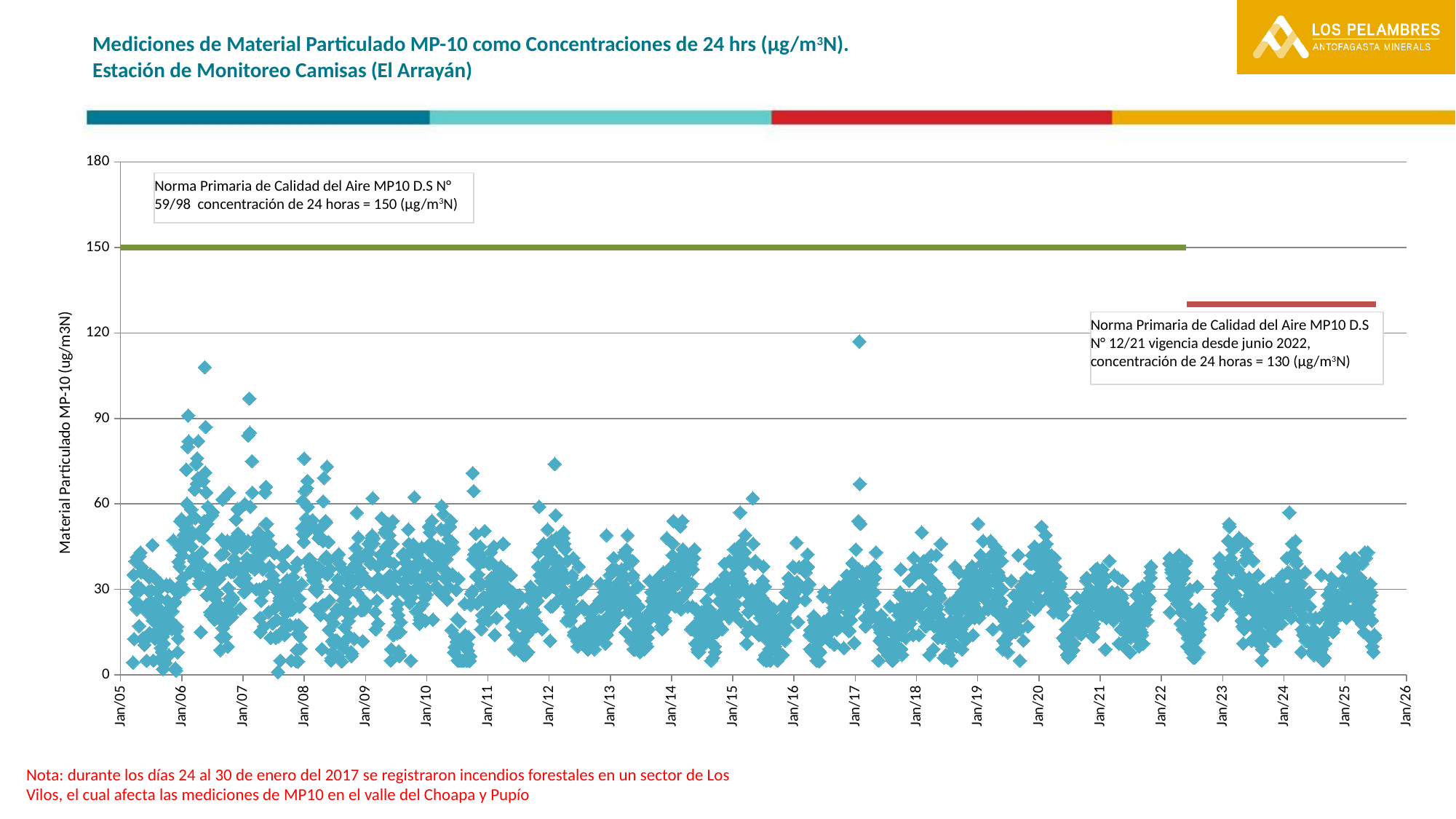
Is the highest plotted MP-10 measurement greater or less than 90? greater What is the label of the vertical axis? Material Particulado MP-10 (ug/m3N) Is the highest plotted MP-10 measurement greater or less than 150? less Is the highest plotted MP-10 measurement greater or less than 120? less What is the maximum value shown on the vertical axis? 180 Since when has the D.S N° 12/21 standard been in force, according to the chart annotation? junio 2022 What is the 24-hour concentration limit set by the Norma Primaria de Calidad del Aire MP10 D.S N° 12/21, as stated on the chart? 130 (µg/m³N) Around which year does the highest MP-10 measurement on the chart occur? 2017 Which of the two reference lines is higher on the chart, the green one or the red one? the green one What kind of chart is shown on the slide? scatter chart By how much does the 150 (µg/m³N) limit of D.S N° 59/98 exceed the 130 (µg/m³N) limit of D.S N° 12/21? 20 (µg/m³N) What is the 24-hour concentration limit set by the Norma Primaria de Calidad del Aire MP10 D.S N° 59/98, as stated on the chart? 150 (µg/m³N)